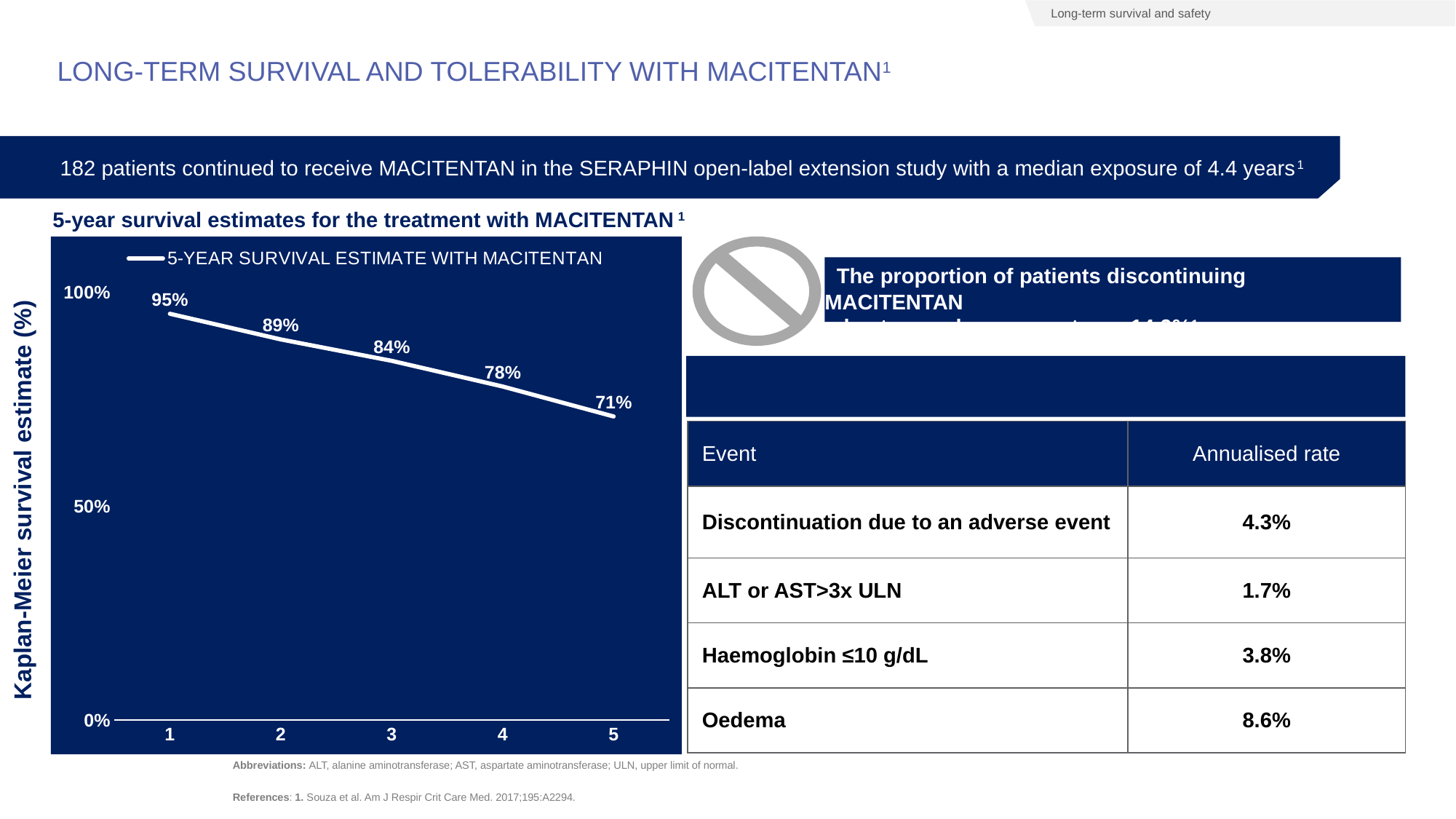
What is the 5-year survival estimate with macitentan at year 5? 71% How many data points are plotted on the survival line? 5 At which year is the survival estimate lowest? 5 What kind of chart is used to show the 5-year survival estimates? Line chart Is the survival estimate at year 5 greater or less than 50%? greater At which year is the survival estimate highest? 1 What is the 5-year survival estimate with macitentan at year 3? 84% What is the difference between the survival estimate at year 1 and at year 5? 24% Which is larger, the survival estimate at year 2 or at year 4? Year 2 What is the difference between the survival estimate at year 2 and at year 4? 11% What is the 5-year survival estimate with macitentan at year 1? 95% Do the survival estimates rise or fall from year 1 to year 5? Fall